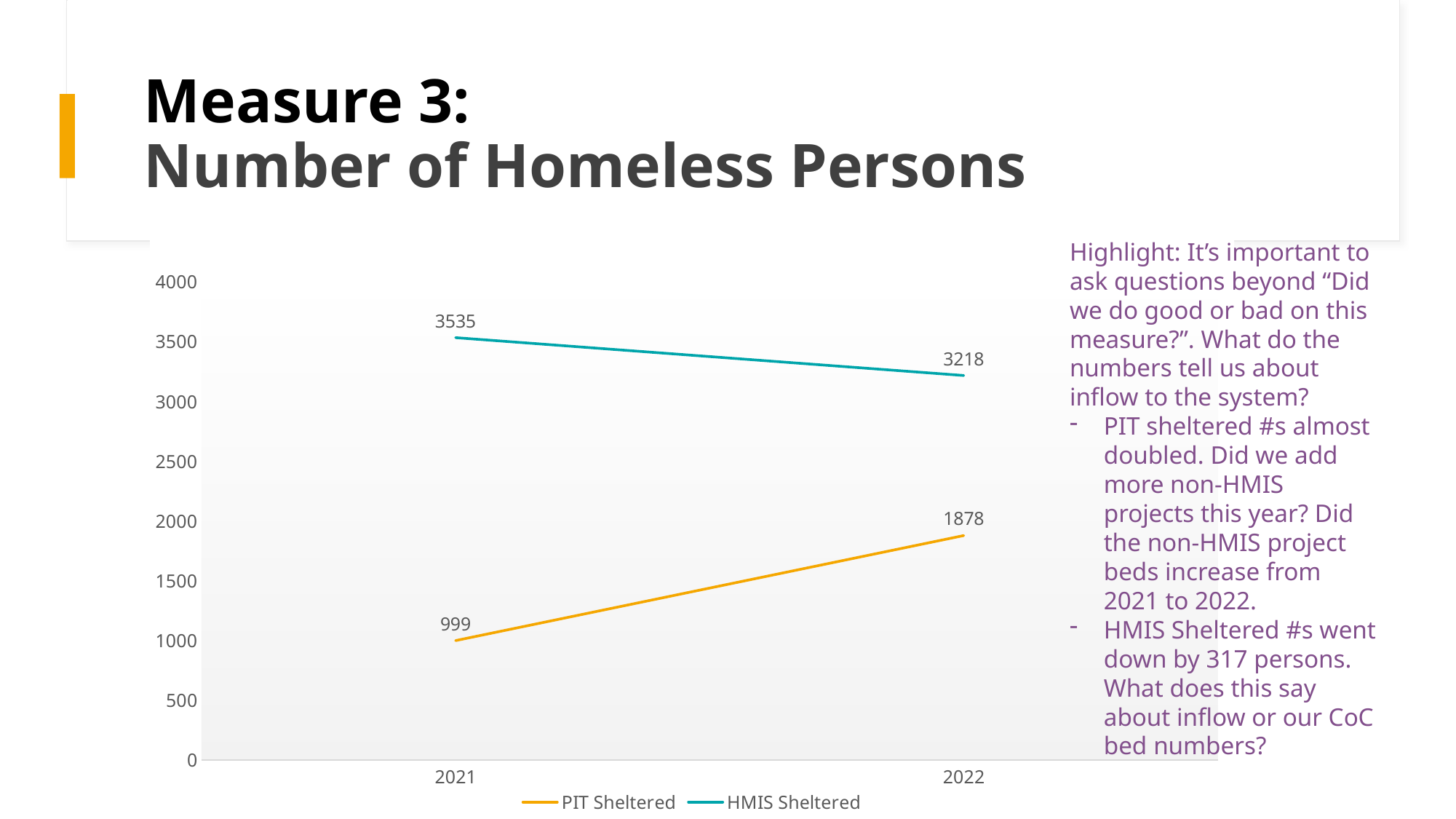
Does the HMIS Sheltered series rise or fall from 2021 to 2022? fall By how much did HMIS Sheltered change from 2021 to 2022? 317 Does the PIT Sheltered series rise or fall from 2021 to 2022? rise What colour is the line for PIT Sheltered? orange Which series has the higher value in 2022, PIT Sheltered or HMIS Sheltered? HMIS Sheltered What is the value for HMIS Sheltered in 2022? 3218 What is the value for PIT Sheltered in 2021? 999 What kind of chart is shown on the slide? line chart What is the value for PIT Sheltered in 2022? 1878 What is the difference between PIT Sheltered in 2022 and PIT Sheltered in 2021? 879 What is the value for HMIS Sheltered in 2021? 3535 How many series does the legend list? 2